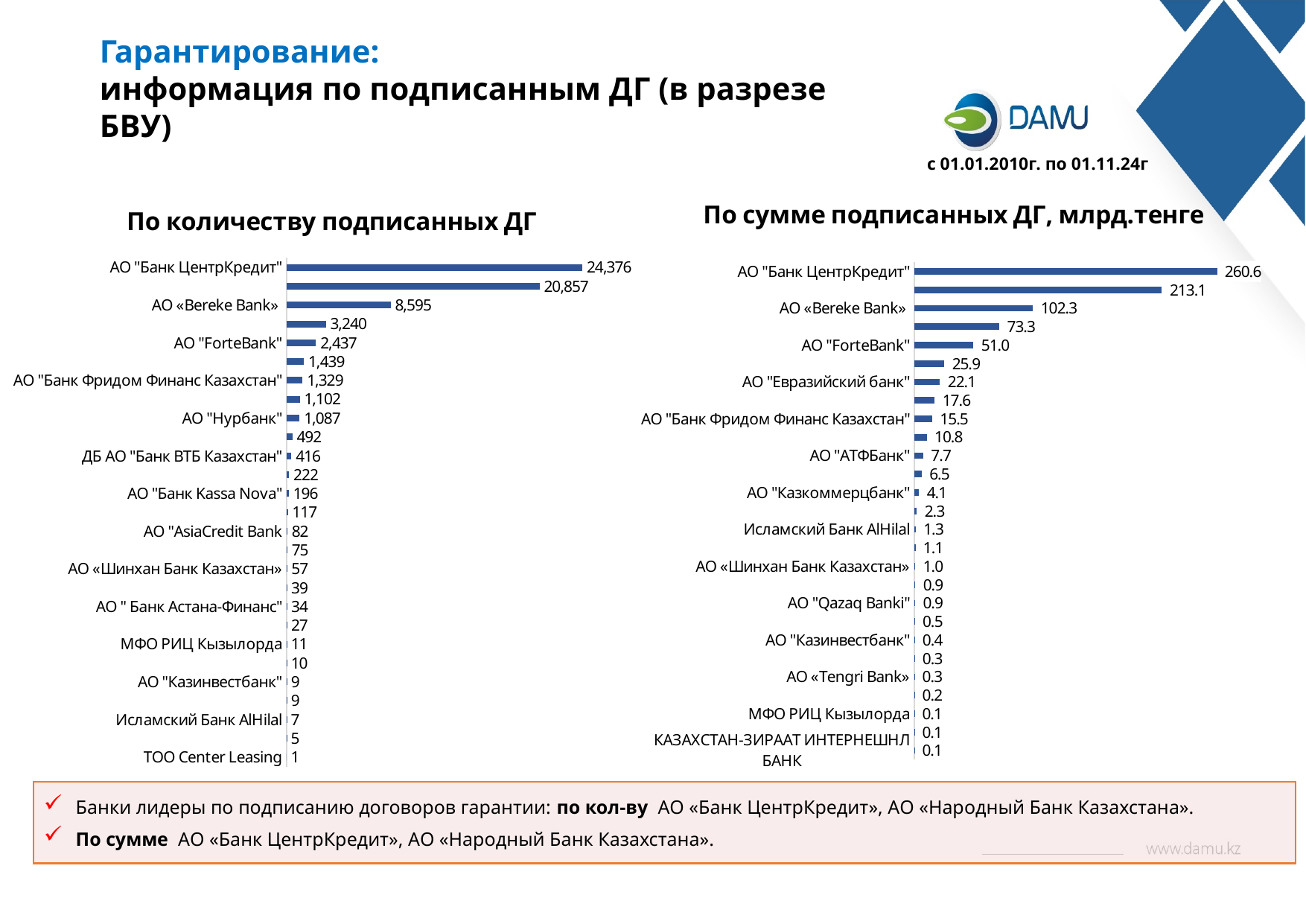
In the chart "По сумме подписанных ДГ, млрд.тенге", which category has the highest value? АО "Банк ЦентрКредит" In the chart "По количеству подписанных ДГ", what is the difference between АО "ForteBank" and АО "Банк Фридом Финанс Казахстан"? 1,108 In the chart "По количеству подписанных ДГ", what is the value for АО "Нурбанк"? 1,087 In the chart "По сумме подписанных ДГ, млрд.тенге", which is larger: АО «Bereke Bank» or АО "ForteBank"? АО «Bereke Bank» In the chart "По количеству подписанных ДГ", what is the value for АО "Банк ЦентрКредит"? 24,376 In the chart "По сумме подписанных ДГ, млрд.тенге", what is the value for АО "Евразийский банк"? 22.1 In the chart "По количеству подписанных ДГ", what is the value for АО «Bereke Bank»? 8,595 What type of chart is used for "По количеству подписанных ДГ"? Bar chart In the chart "По сумме подписанных ДГ, млрд.тенге", what is the value for АО "Банк ЦентрКредит"? 260.6 In the chart "По количеству подписанных ДГ", which category has the lowest value? ТОО Center Leasing In the chart "По сумме подписанных ДГ, млрд.тенге", what is the difference between АО «Bereke Bank» and АО "ForteBank"? 51.3 In the chart "По сумме подписанных ДГ, млрд.тенге", what is the value for АО "АТФБанк"? 7.7